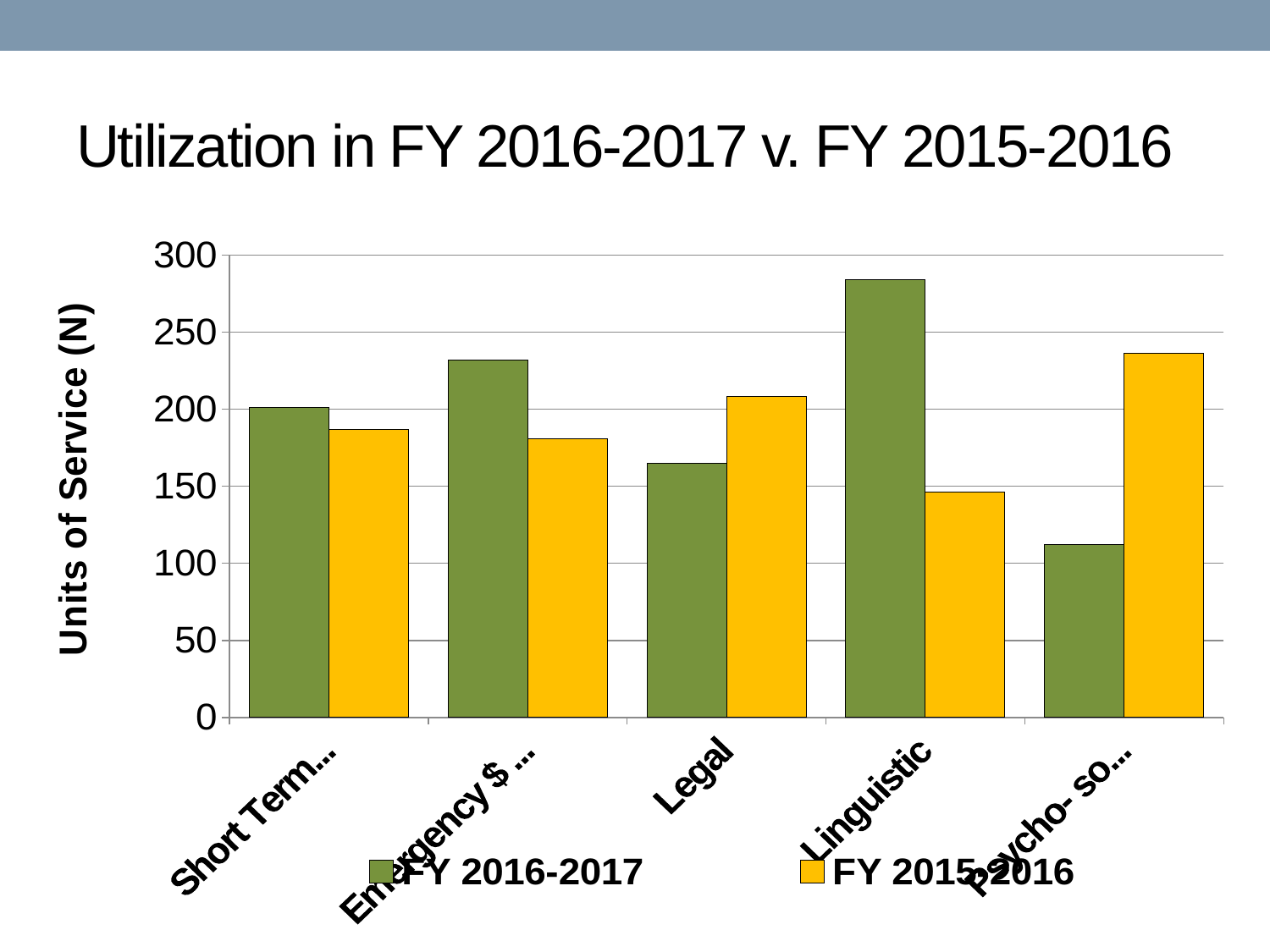
What is the title of the chart? Utilization in FY 2016-2017 v. FY 2015-2016 For Linguistic, which series has the larger value, FY 2016-2017 or FY 2015-2016? FY 2016-2017 Which category has the highest value for FY 2016-2017? Linguistic How many series does the legend list? 2 For Legal, which series has the larger value, FY 2016-2017 or FY 2015-2016? FY 2015-2016 Is the FY 2016-2017 value for Legal greater or less than 200? less What is the label on the y axis? Units of Service (N) What kind of chart is shown on the slide? bar chart Which category has the lowest value for FY 2015-2016? Linguistic How many categories are shown on the x axis? 5 Is the FY 2015-2016 value for Linguistic greater or less than 200? less Is the FY 2016-2017 value for Linguistic greater or less than 250? greater